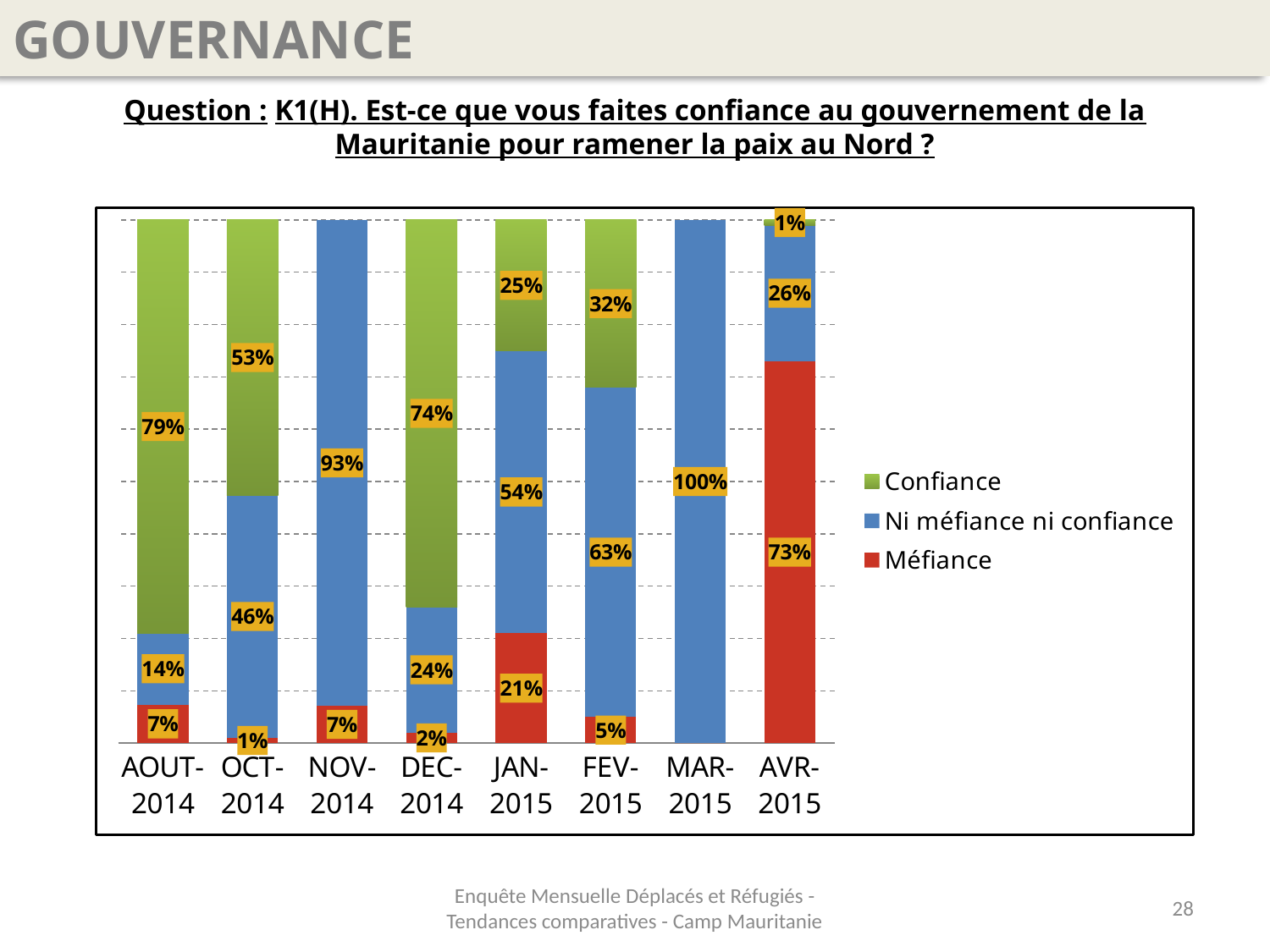
Which series is shown in red? Méfiance How many series does the legend list? 3 In which month is the 'Confiance' share the lowest among the months where it is labelled? AVR-2015 What kind of chart is shown on the slide? Stacked bar chart What is the difference between the 'Confiance' values for AOUT-2014 and OCT-2014? 26% How many months are shown on the x axis? 8 What is the 'Méfiance' value for AVR-2015? 73% Which is larger: the 'Ni méfiance ni confiance' value for FEV-2015 or for JAN-2015? FEV-2015 What is the 'Confiance' value for JAN-2015? 25% What percentage of respondents answered 'Confiance' in AOUT-2014? 79% What is the 'Ni méfiance ni confiance' value for MAR-2015? 100% In which month is the 'Méfiance' share the highest? AVR-2015